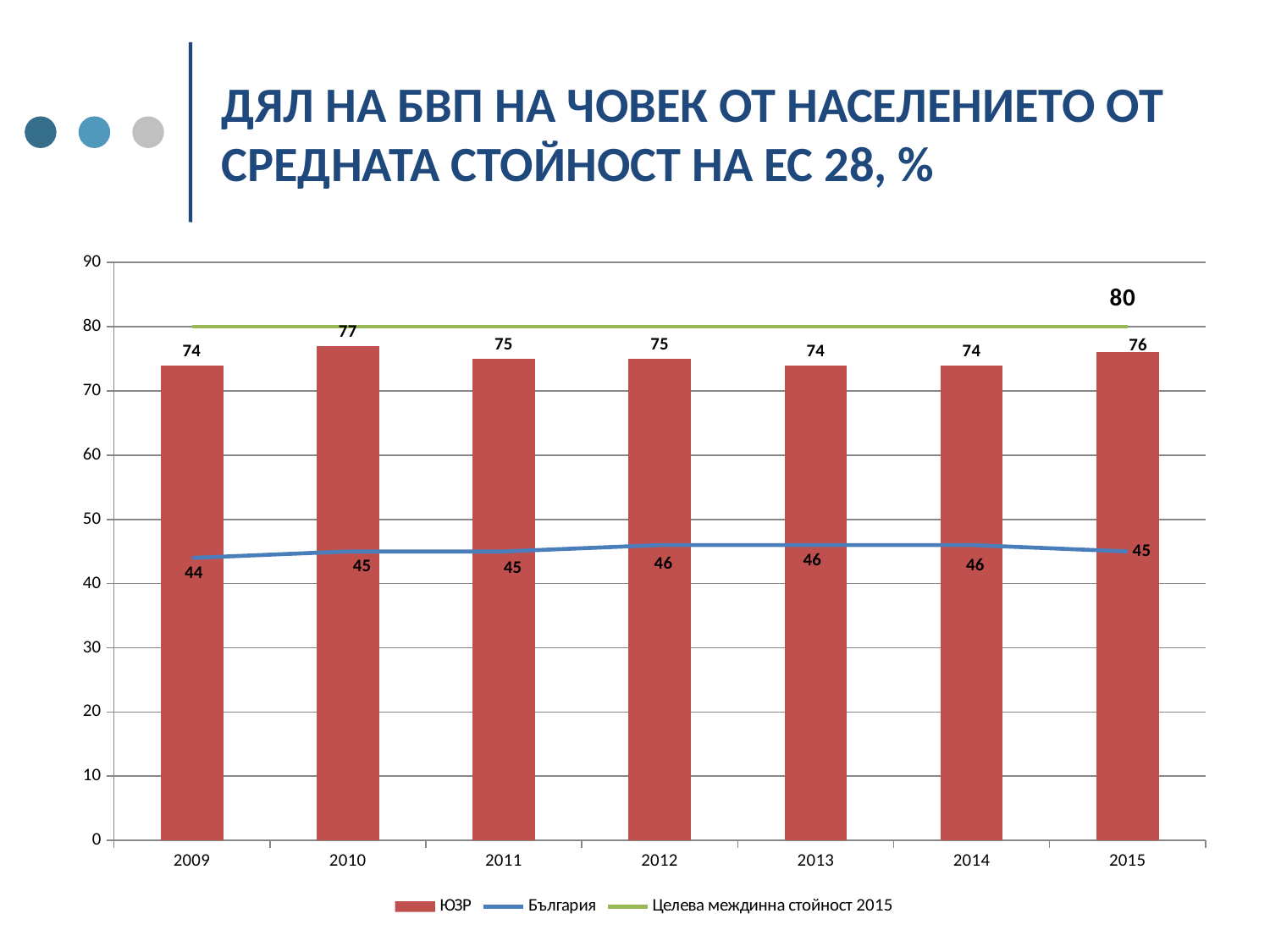
In which year is the ЮЗР value highest? 2010 Which is larger in 2013: the ЮЗР value or the България value? ЮЗР What is the difference between the ЮЗР value and the България value in 2012? 29 In which year is the България value lowest? 2009 How many series does the legend list? 3 What is the value for ЮЗР in 2015? 76 Is the ЮЗР value for 2011 greater or less than 80? less What is the value for България in 2009? 44 How many years are shown on the x axis? 7 What colour are the ЮЗР bars? Red What value does the Целева междинна стойност 2015 line show? 80 What is the value for ЮЗР in 2010? 77